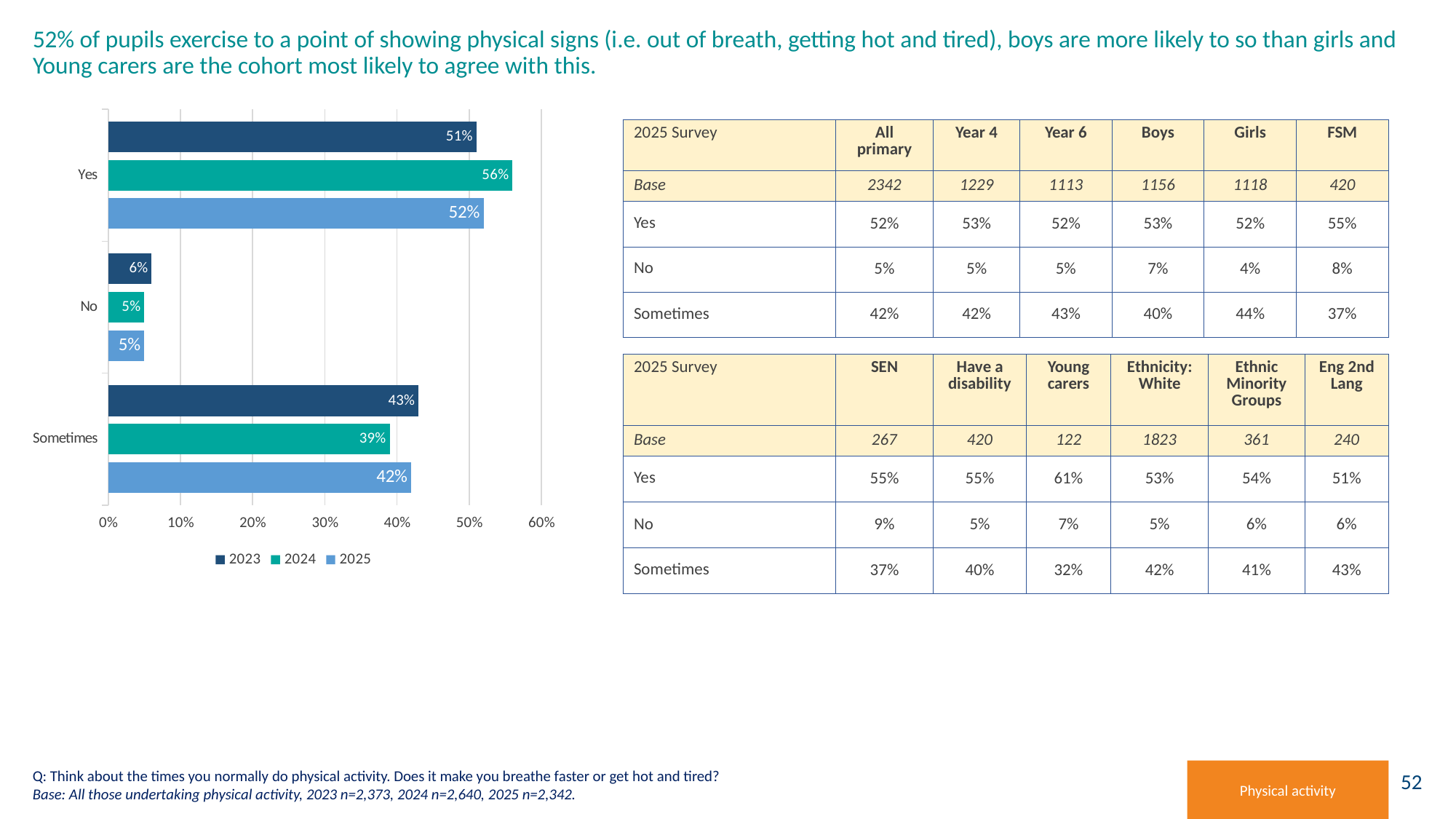
How many categories are shown on the chart? 3 How many series does the legend list? 3 Which category has the lowest value for the 2024 series? No Which series is shown in the darkest blue colour? 2023 What is the difference between the Yes values for 2024 and 2023? 5% What is the value for Yes in 2024? 56% What is the difference between the Sometimes values for 2023 and 2024? 4% What is the value for Sometimes in 2025? 42% Which category has the highest value for the 2025 series? Yes Which is larger, the Sometimes value for 2023 or for 2025? 2023 What is the value for No in 2023? 6% What kind of chart is shown on the slide? Bar chart